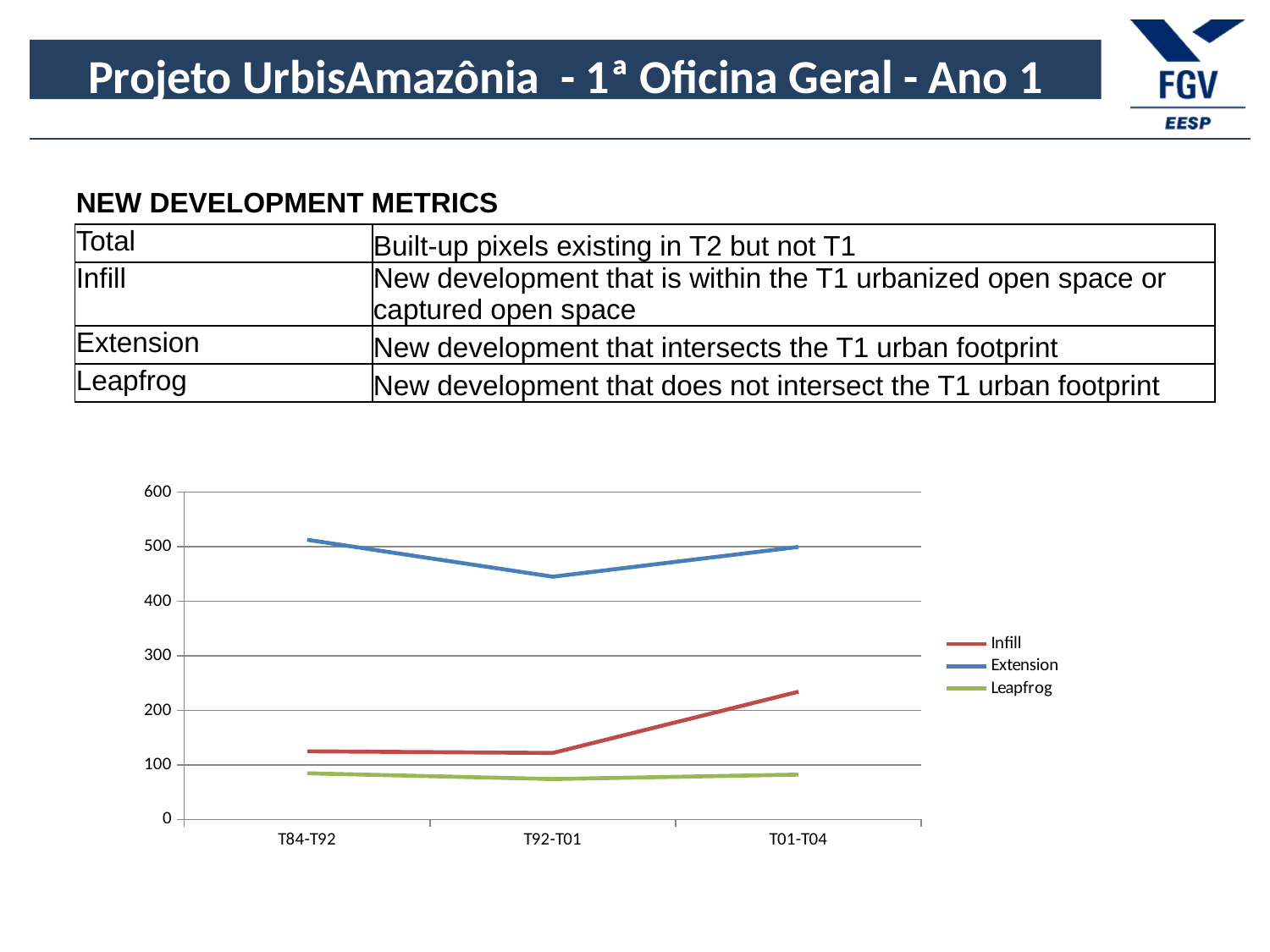
Does the Infill line rise or fall from T92-T01 to T01-T04? rise Is the Leapfrog value for T84-T92 greater or less than 100? less In which period is the Extension value lowest? T92-T01 In which period is the Infill value highest? T01-T04 What kind of chart is shown on the slide? line chart Which is larger at T01-T04, the Infill value or the Leapfrog value? Infill Is the Infill value for T01-T04 greater or less than 200? greater Which series has the highest values across all periods in the chart? Extension Is the Extension value for T92-T01 greater or less than 500? less Which series has the lowest values across all periods in the chart? Leapfrog How many periods are shown along the x axis of the chart? 3 How many series does the chart legend list? 3